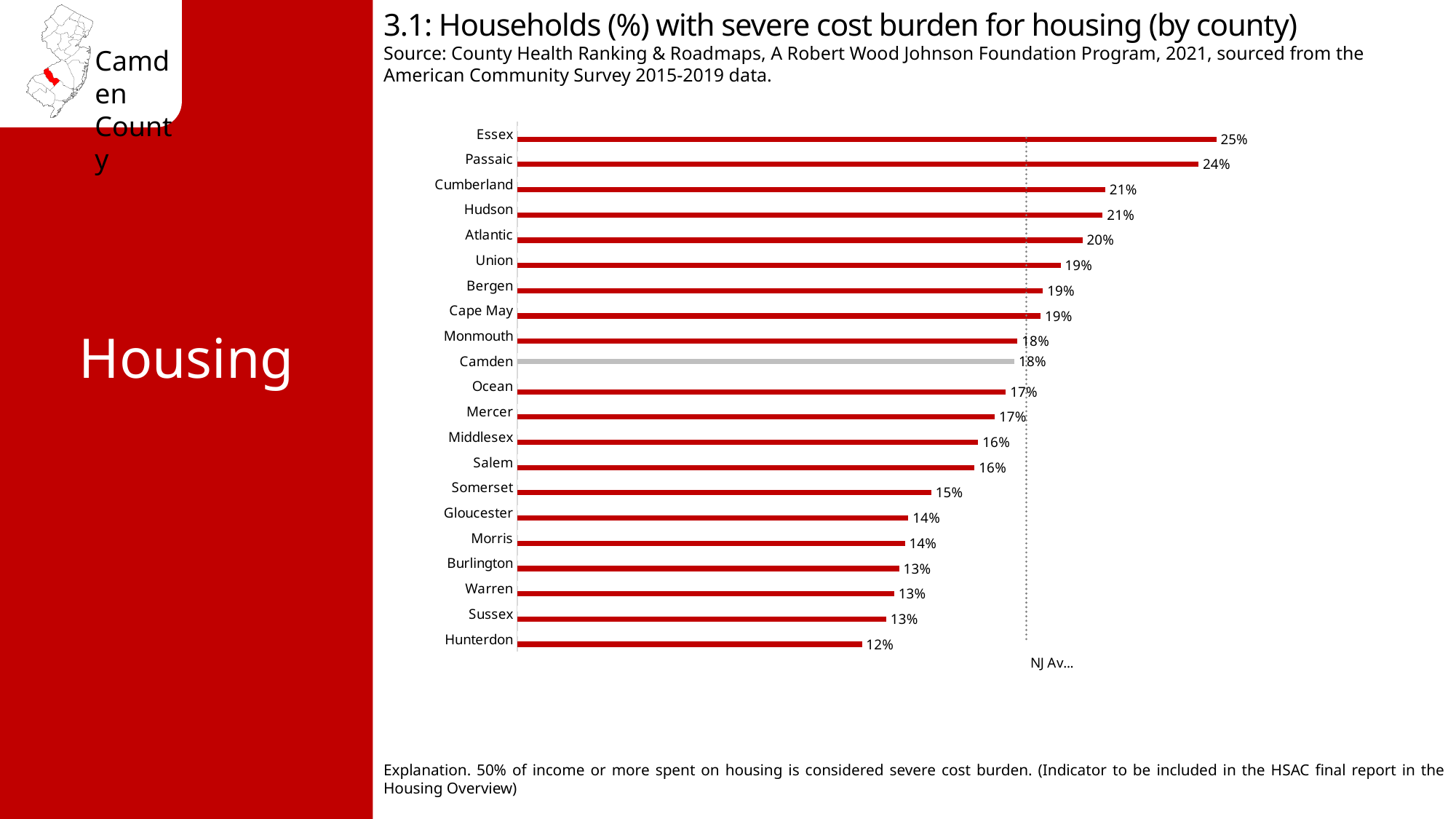
How many counties are shown in the chart? 21 What percentage of households in Camden County have a severe cost burden for housing? 18% What kind of chart is shown on the slide? Bar chart Which county has the lowest percentage of households with severe housing cost burden? Hunterdon What is the value shown for Essex? 25% Which county has the highest percentage of households with severe housing cost burden? Essex What is the difference between the values for Essex and Hunterdon? 13% Which county's bar is shown in grey rather than red? Camden Which has a higher value, Atlantic or Somerset? Atlantic What is the difference between the values for Passaic and Camden? 6% What is the value shown for Hunterdon? 12% What is the value shown for Gloucester? 14%